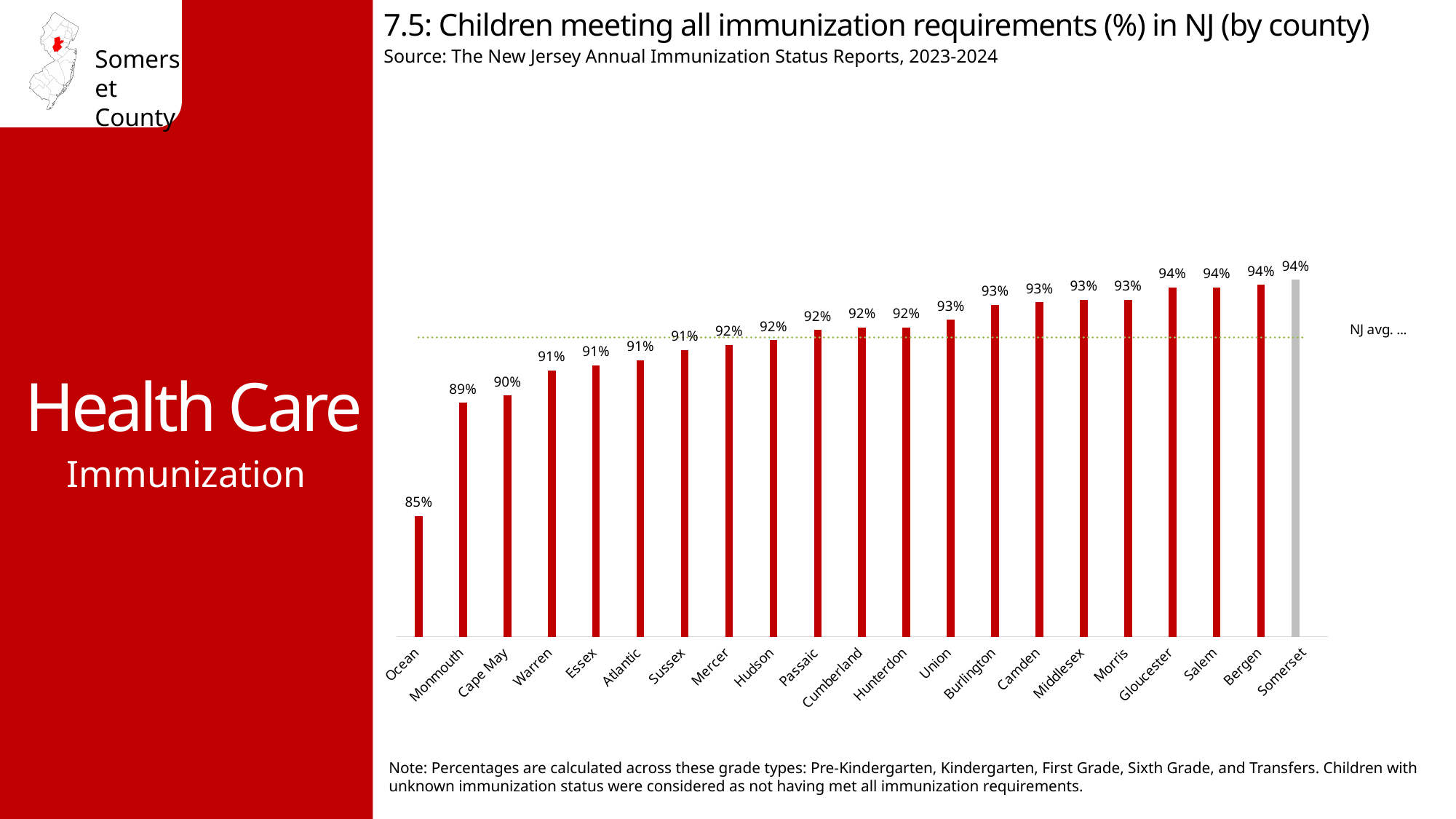
Which has a higher value, Ocean County or Monmouth County? Monmouth What is the difference in percentage points between Somerset County and Ocean County? 9 percentage points What kind of chart is shown on the slide? Bar chart What is the value shown for Somerset County? 94% Which county has the lowest percentage of children meeting all immunization requirements? Ocean Do the values generally rise or fall moving from left to right along the x axis? Rise How many counties are shown on the chart? 21 What is the value shown for Monmouth County? 89% What is the value shown for Cape May County? 90% Which county's bar is coloured grey instead of red? Somerset What is the value shown for Union County? 93% What percentage of children in Ocean County met all immunization requirements? 85%